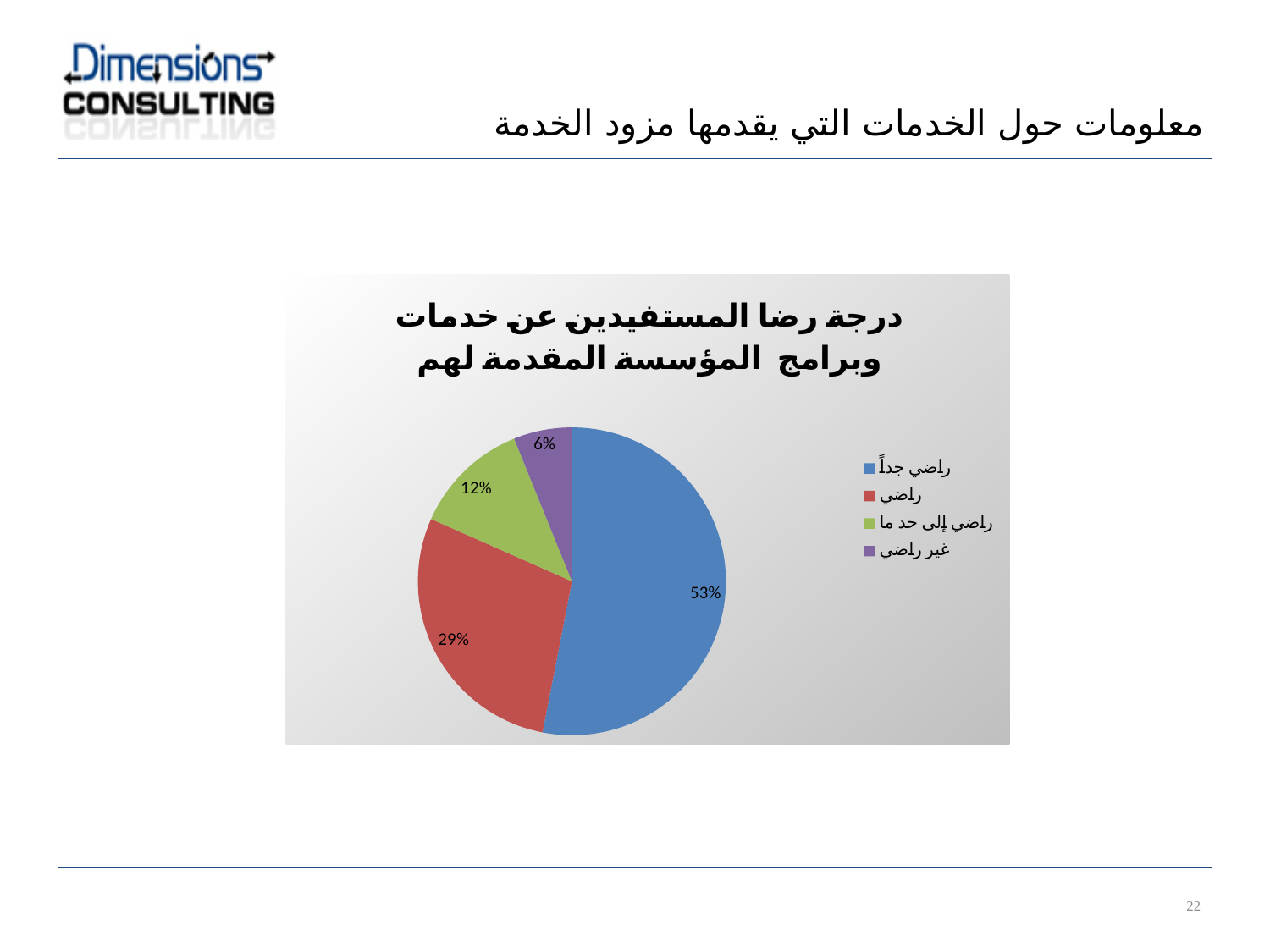
What share of the pie does راضي جداً have? 53% What share of the pie does غير راضي have? 6% How many entries does the legend list? 4 Which is larger, the slice for راضي إلى حد ما or the slice for غير راضي? راضي إلى حد ما What share of the pie does راضي إلى حد ما have? 12% Which category has the smallest slice of the pie? غير راضي How many slices does the pie chart have? 4 Which category has the largest slice of the pie? راضي جداً What is the difference in percentage points between راضي جداً and راضي? 24% What kind of chart is shown on the slide? pie chart What colour is the slice for راضي? red